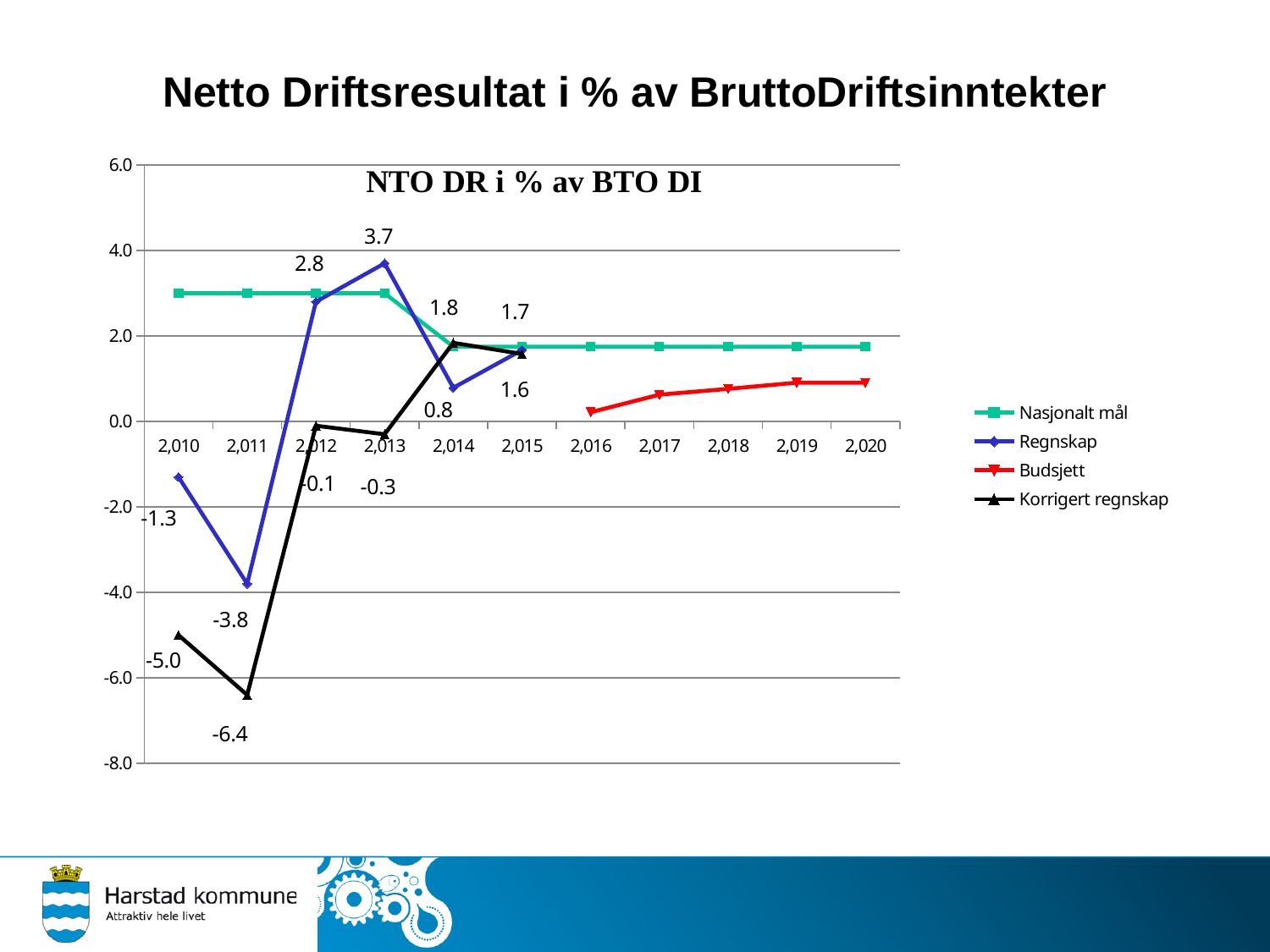
What is the Korrigert regnskap value for 2011? -6.4 What is the Regnskap value for 2013? 3.7 In 2014, which is larger: Regnskap or Korrigert regnskap? Korrigert regnskap In which year does the Korrigert regnskap series reach its lowest value? 2011 Does the Budsjett series rise or fall from 2016 to 2019? Rise How many series does the legend list? 4 In which year does the Regnskap series reach its highest value? 2013 What is the Regnskap value for 2010? -1.3 Is the Budsjett value for 2016 greater or less than 2.0? less What kind of chart is shown on the slide? Line chart How many years are shown on the x axis? 11 What is the difference between the Regnskap values for 2013 and 2012? 0.9